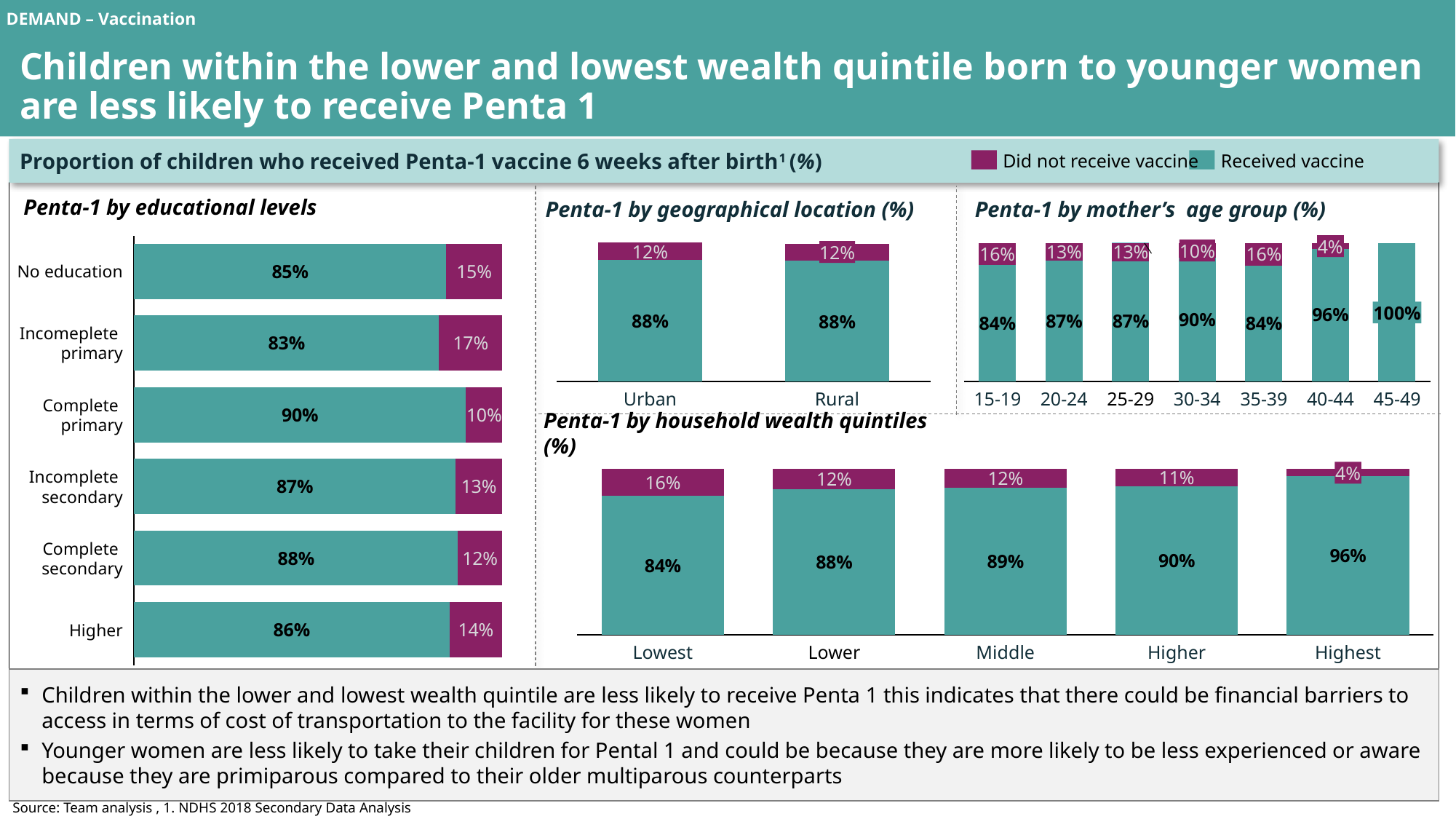
In the 'Penta-1 by educational levels' chart, which educational level has the lowest share of children who received the vaccine? Incomeplete primary In the 'Penta-1 by household wealth quintiles' chart, what percentage of children in the Lowest quintile did not receive the vaccine? 16% In the 'Penta-1 by educational levels' chart, which educational level has the highest share of children who received the vaccine? Complete primary In the 'Penta-1 by household wealth quintiles' chart, which quintile has the highest share of children who received the vaccine? Highest In the 'Penta-1 by household wealth quintiles' chart, is the received-vaccine percentage larger for the Middle or the Lower quintile? Middle In the 'Penta-1 by mother's age group' chart, how many age groups are shown? 7 How many series does the legend at the top of the slide list? 2 In the 'Penta-1 by educational levels' chart, what percentage of children of mothers with no education received the vaccine? 85% In the 'Penta-1 by mother's age group' chart, what is the difference in the received-vaccine percentage between the 30-34 and 15-19 age groups? 6% In the 'Penta-1 by geographical location' chart, what percentage of rural children did not receive the vaccine? 12% In the 'Penta-1 by educational levels' chart, how many educational levels are shown? 6 In the 'Penta-1 by mother's age group' chart, what percentage of children of mothers aged 45-49 received the vaccine? 100%